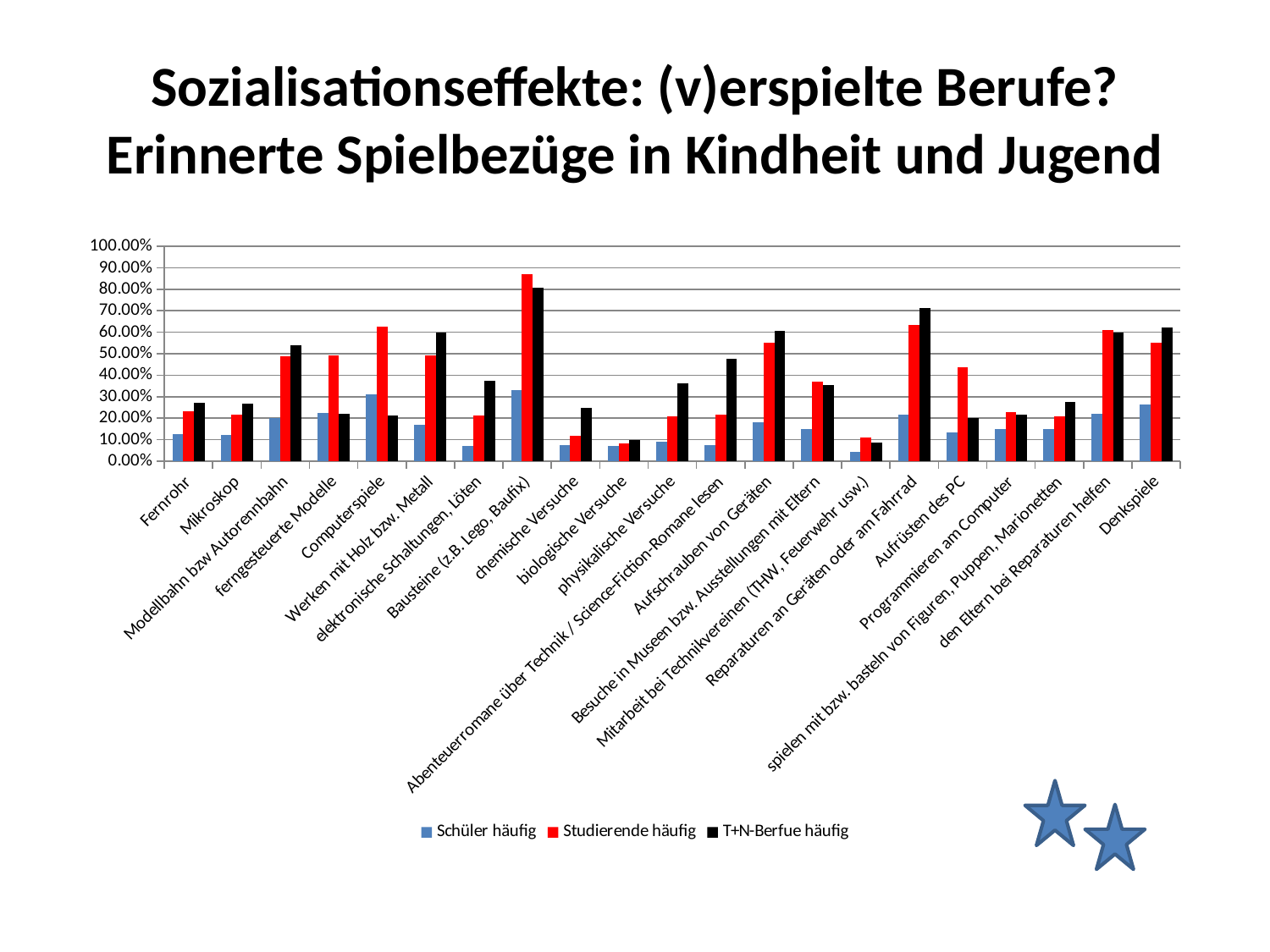
Is the value for 'T+N-Berfue häufig' in the category 'Reparaturen an Geräten oder am Fahrrad' greater or less than 60.00%? greater For the category 'Computerspiele', which series has the larger value: 'Studierende häufig' or 'T+N-Berfue häufig'? Studierende häufig Is the value for 'Schüler häufig' in the category 'Mitarbeit bei Technikvereinen (THW, Feuerwehr usw.)' greater or less than 10.00%? less Which category has the highest value for the series 'T+N-Berfue häufig'? Bausteine (z.B. Lego, Baufix) Which category has the highest value for the series 'Studierende häufig'? Bausteine (z.B. Lego, Baufix) Which category has the lowest value for the series 'Schüler häufig'? Mitarbeit bei Technikvereinen (THW, Feuerwehr usw.) What kind of chart is shown on the slide? bar chart What colour are the bars for the series 'Studierende häufig'? red Is the value for 'Studierende häufig' in the category 'Bausteine (z.B. Lego, Baufix)' greater or less than 80.00%? greater How many categories are shown on the x axis? 21 For the category 'Bausteine (z.B. Lego, Baufix)', which series has the larger value: 'Schüler häufig' or 'Studierende häufig'? Studierende häufig How many series does the legend list? 3